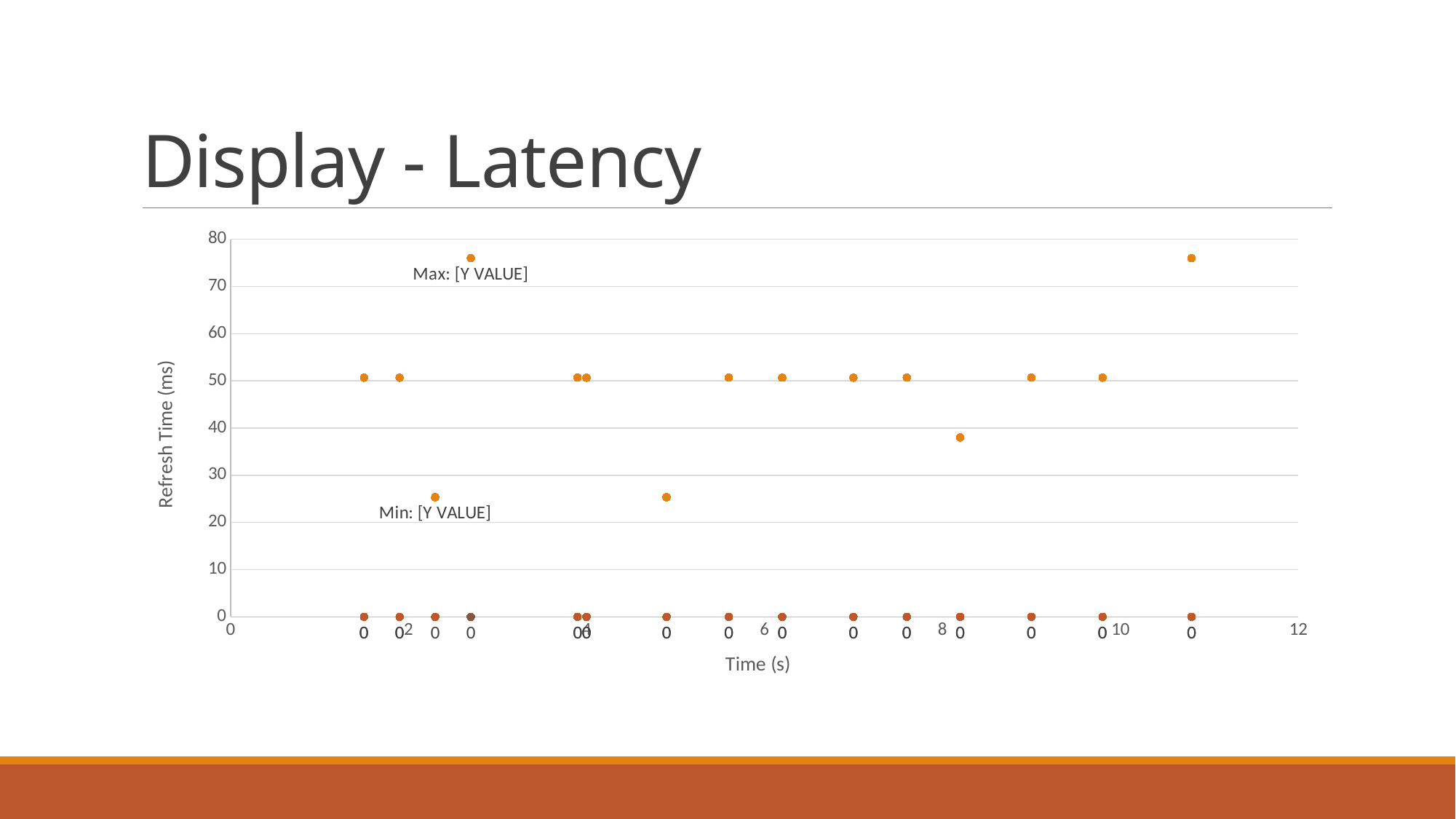
What value is printed as the data label on the points lying along the horizontal axis? 0 What is the title of the slide containing the chart? Display - Latency What is the label of the vertical axis of the chart? Refresh Time (ms) Is the refresh time point plotted at about 8 seconds (between the 50 and 30 gridlines) greater or less than 40? less What is the highest tick value shown on the horizontal axis? 12 What kind of chart is shown on the slide? scatter chart Is the refresh time point plotted near 11 seconds greater or less than 60? greater Is the highest plotted refresh time greater or less than 70? greater